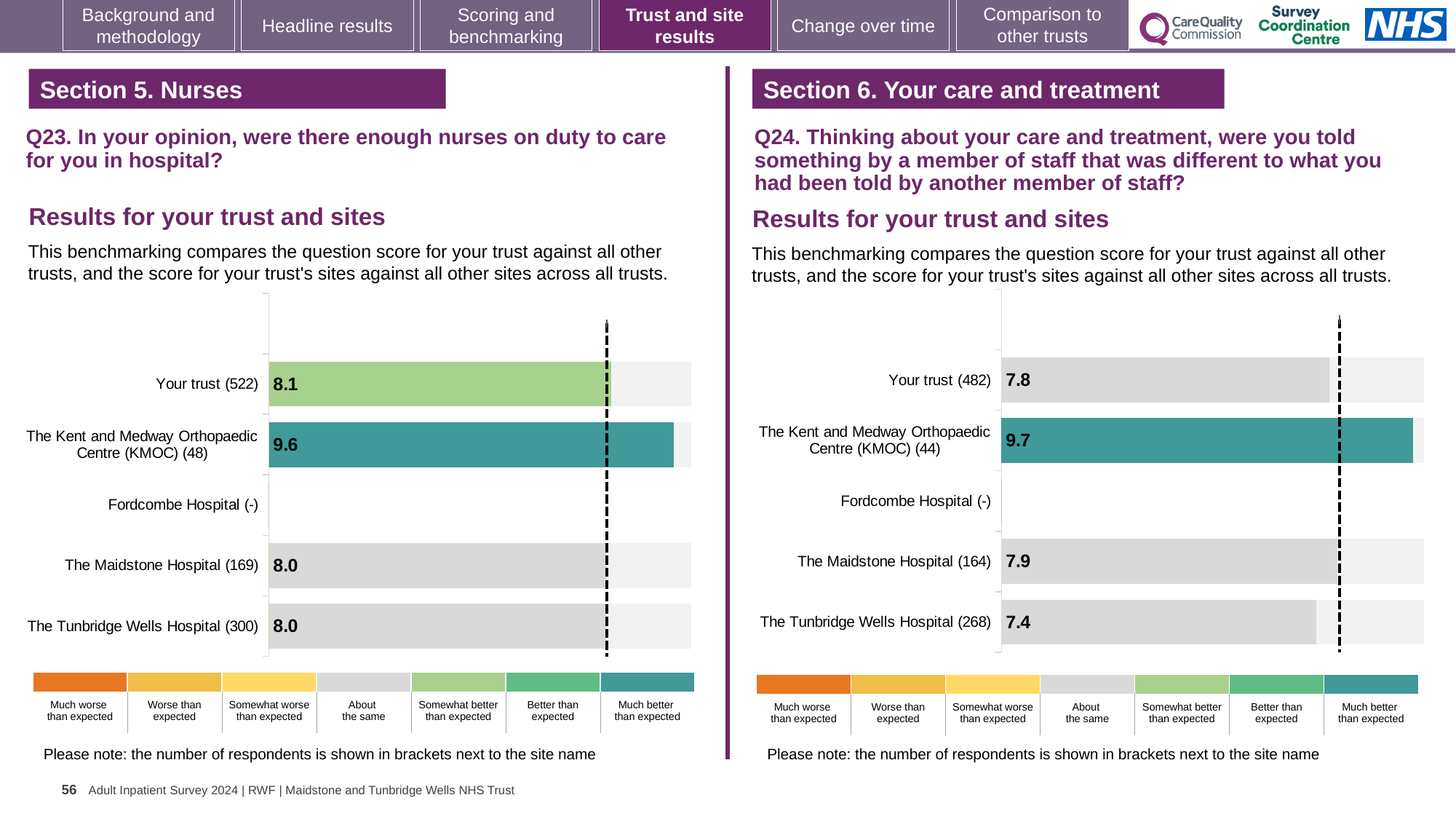
On the Q23 chart (left), which site has the highest score? The Kent and Medway Orthopaedic Centre (KMOC) (48) On the Q23 chart (left), what is the score for The Kent and Medway Orthopaedic Centre (KMOC) (48)? 9.6 On the Q24 chart (right), what is the difference between the scores for The Kent and Medway Orthopaedic Centre (KMOC) and Your trust? 1.9 On the Q24 chart (right), what is the score for The Tunbridge Wells Hospital (268)? 7.4 On the Q24 chart (right), which site has the lowest score? The Tunbridge Wells Hospital (268) On the Q24 chart (right), how many site rows are listed on the y axis, including Your trust? 5 On the Q24 chart (right), which is larger: the score for The Maidstone Hospital or The Tunbridge Wells Hospital? The Maidstone Hospital On the Q23 chart (left), what is the difference between the scores for The Kent and Medway Orthopaedic Centre (KMOC) and The Maidstone Hospital? 1.6 On the Q23 chart (left), what is the score for Your trust (522)? 8.1 On the Q23 chart (left), what kind of chart is shown? Bar chart On the Q23 chart (left), what colour is the bar for Your trust (522)? Light green On the Q24 chart (right), what is the score for Your trust (482)? 7.8